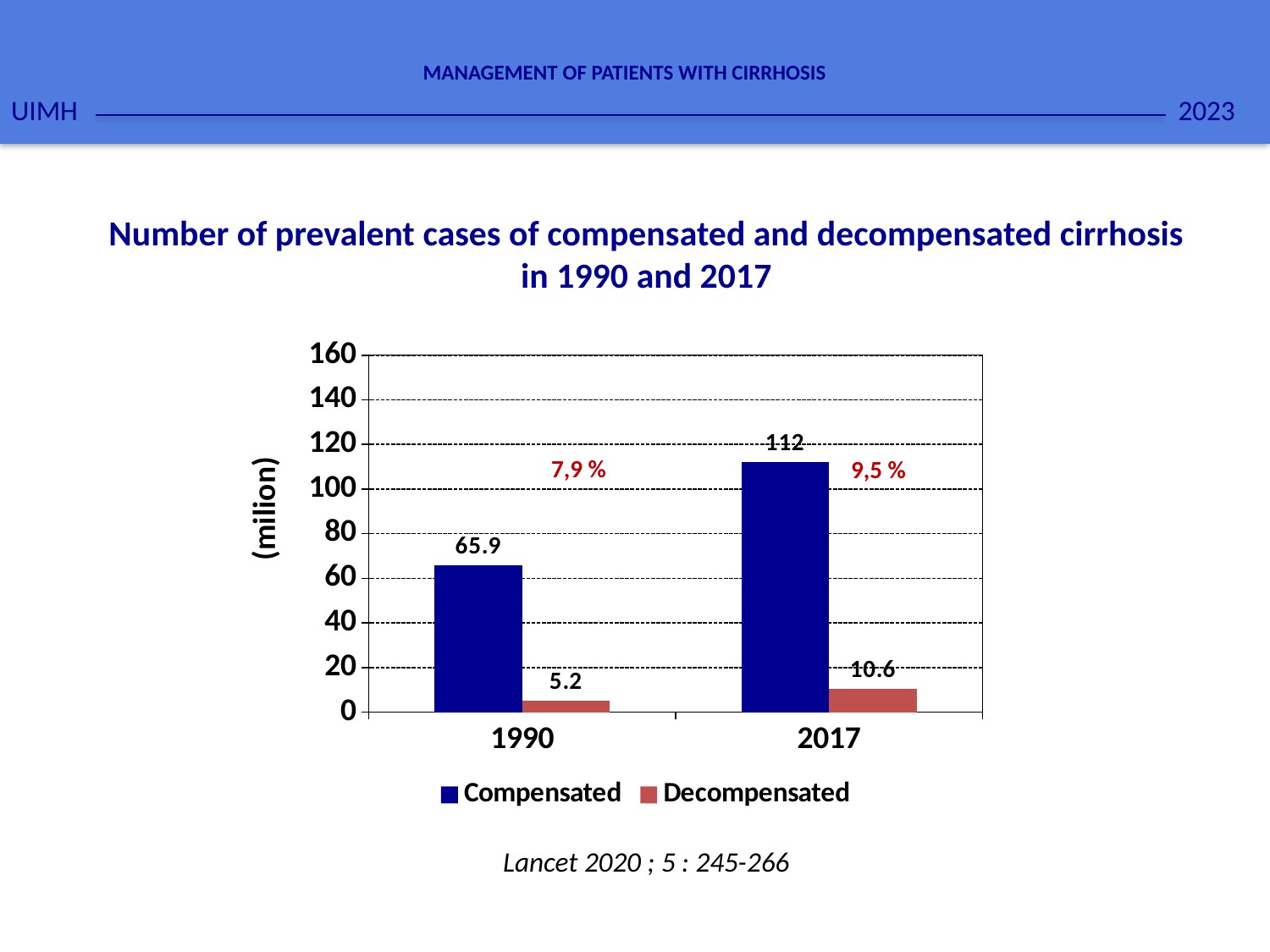
How many series does the legend list? 2 What is the difference between the Compensated values in 2017 and 1990? 46.1 Which year has the lowest value for Decompensated cirrhosis? 1990 What is the value for Compensated cirrhosis in 1990? 65.9 What is the value for Compensated cirrhosis in 2017? 112 What unit is shown on the y-axis label? (milion) What is the value for Decompensated cirrhosis in 1990? 5.2 What is the value for Decompensated cirrhosis in 2017? 10.6 What is the difference between the Decompensated values in 2017 and 1990? 5.4 Which year has the highest value for Compensated cirrhosis? 2017 What kind of chart is shown on the slide? Bar chart Which is larger: Compensated in 1990 or Decompensated in 2017? Compensated in 1990